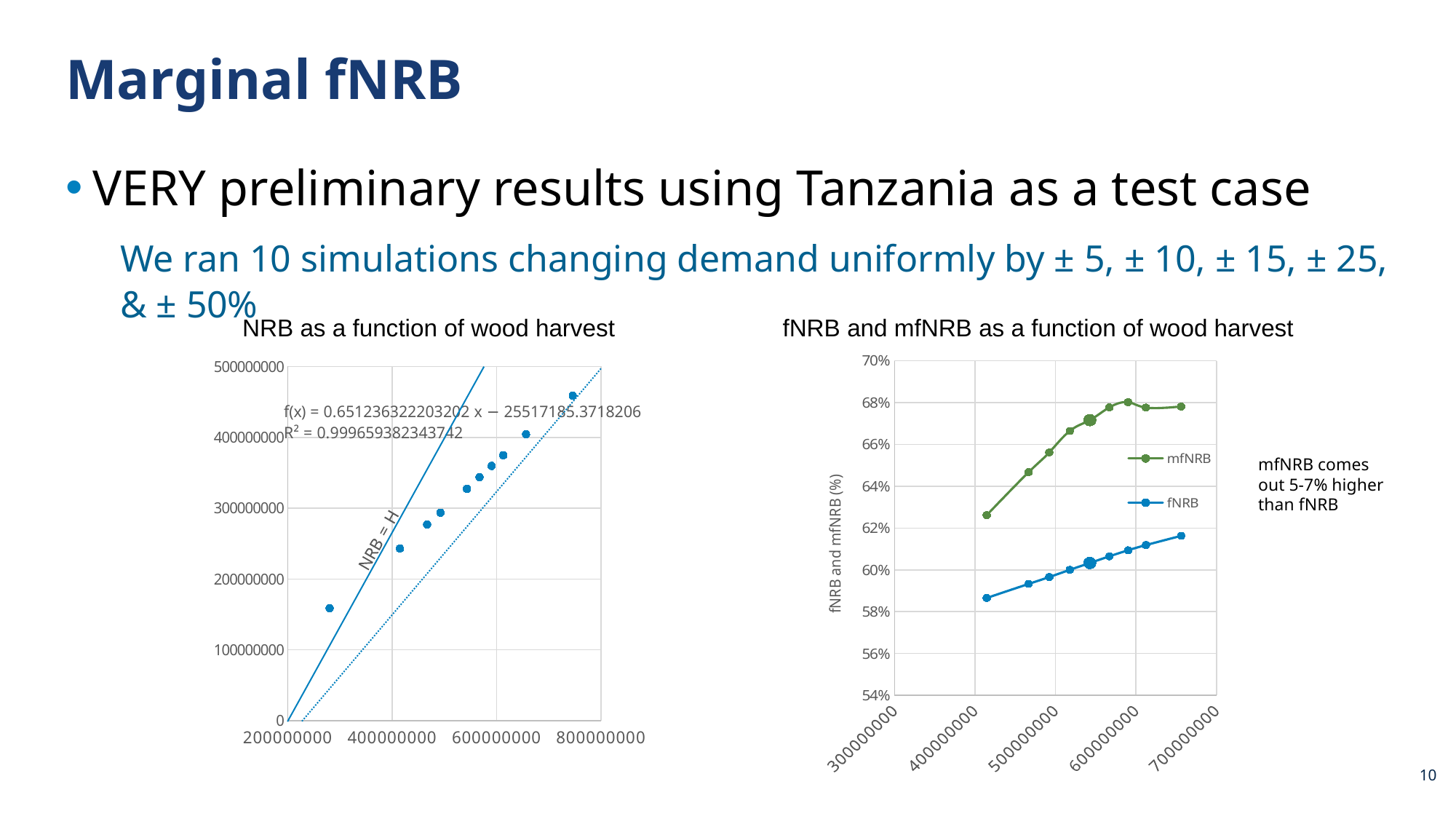
In the right-hand chart, which series is plotted in green? mfNRB In the left-hand chart, is the NRB value of the leftmost point greater or less than 200000000? less In the right-hand chart, which series has higher values across the whole range of wood harvest, mfNRB or fNRB? mfNRB In the right-hand chart, does fNRB rise or fall as wood harvest increases along the x axis? rise In the right-hand chart, is the fNRB value at the lowest wood harvest point greater or less than 60%? less What kind of chart is the left-hand chart, 'NRB as a function of wood harvest'? scatter plot In the left-hand chart, what R² value is printed for the fitted trendline? 0.999659382343742 In the right-hand chart, is the highest mfNRB value greater or less than 66%? greater In the right-hand chart, what are the two series named in the legend? mfNRB and fNRB What kind of chart is the right-hand chart, 'fNRB and mfNRB as a function of wood harvest'? line chart In the right-hand chart, how many series does the legend list? 2